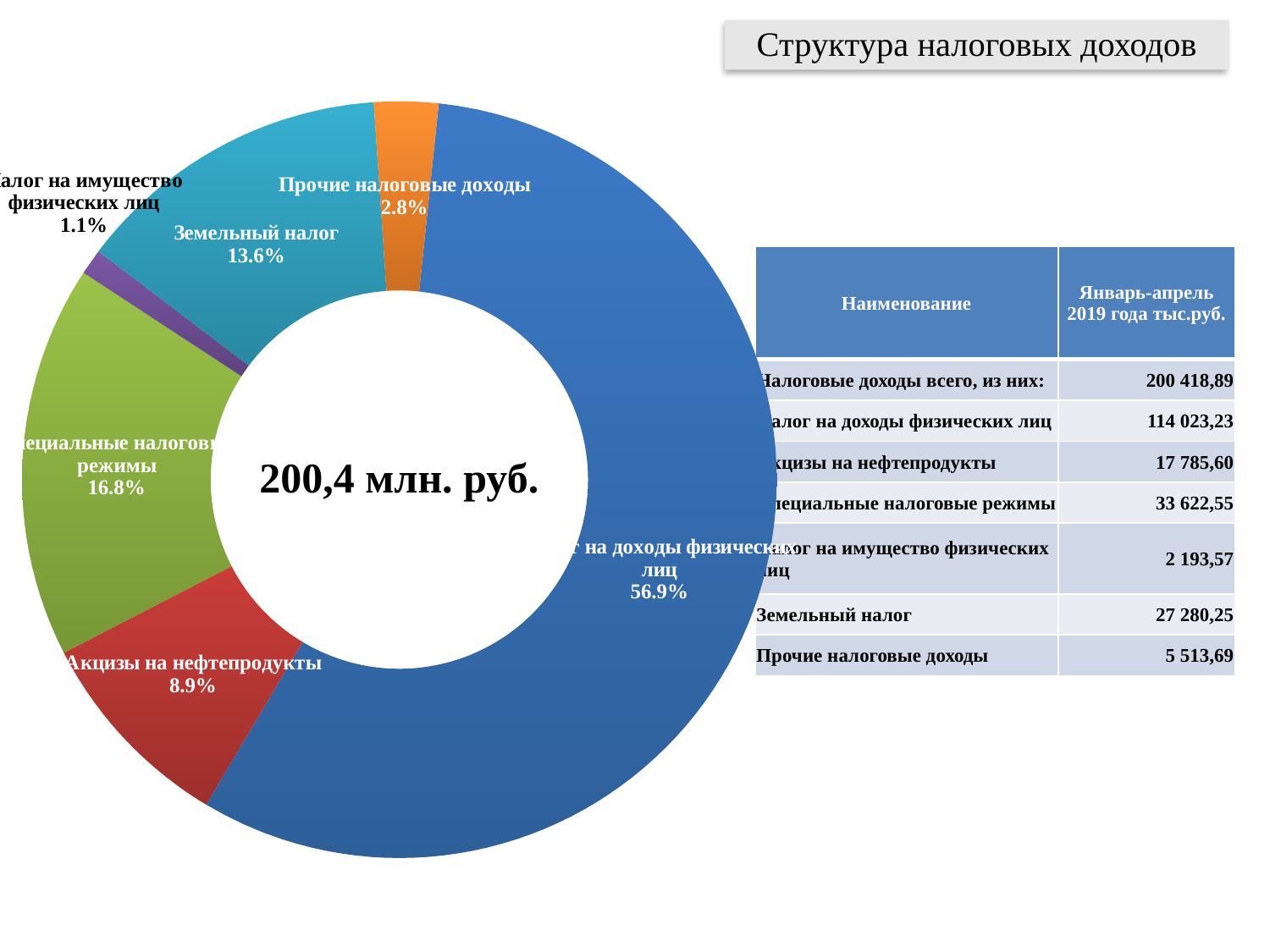
What kind of chart is shown on the slide? Donut (pie) chart Which category has the smallest slice in the chart? Налог на имущество физических лиц What is the difference in percentage points between Специальные налоговые режимы and Акцизы на нефтепродукты in the chart? 7.9 percentage points What share does Прочие налоговые доходы have in the chart? 2.8% What share does Акцизы на нефтепродукты have in the chart? 8.9% What share does Земельный налог have in the chart? 13.6% What total value is shown in the centre of the donut chart? 200,4 млн. руб. What share does Специальные налоговые режимы have in the chart? 16.8% How many slices does the donut chart have? 6 Which category has the largest slice in the chart? Налог на доходы физических лиц What share of tax revenues does Налог на доходы физических лиц account for in the chart? 56.9% Which is larger in the chart: Специальные налоговые режимы or Земельный налог? Специальные налоговые режимы